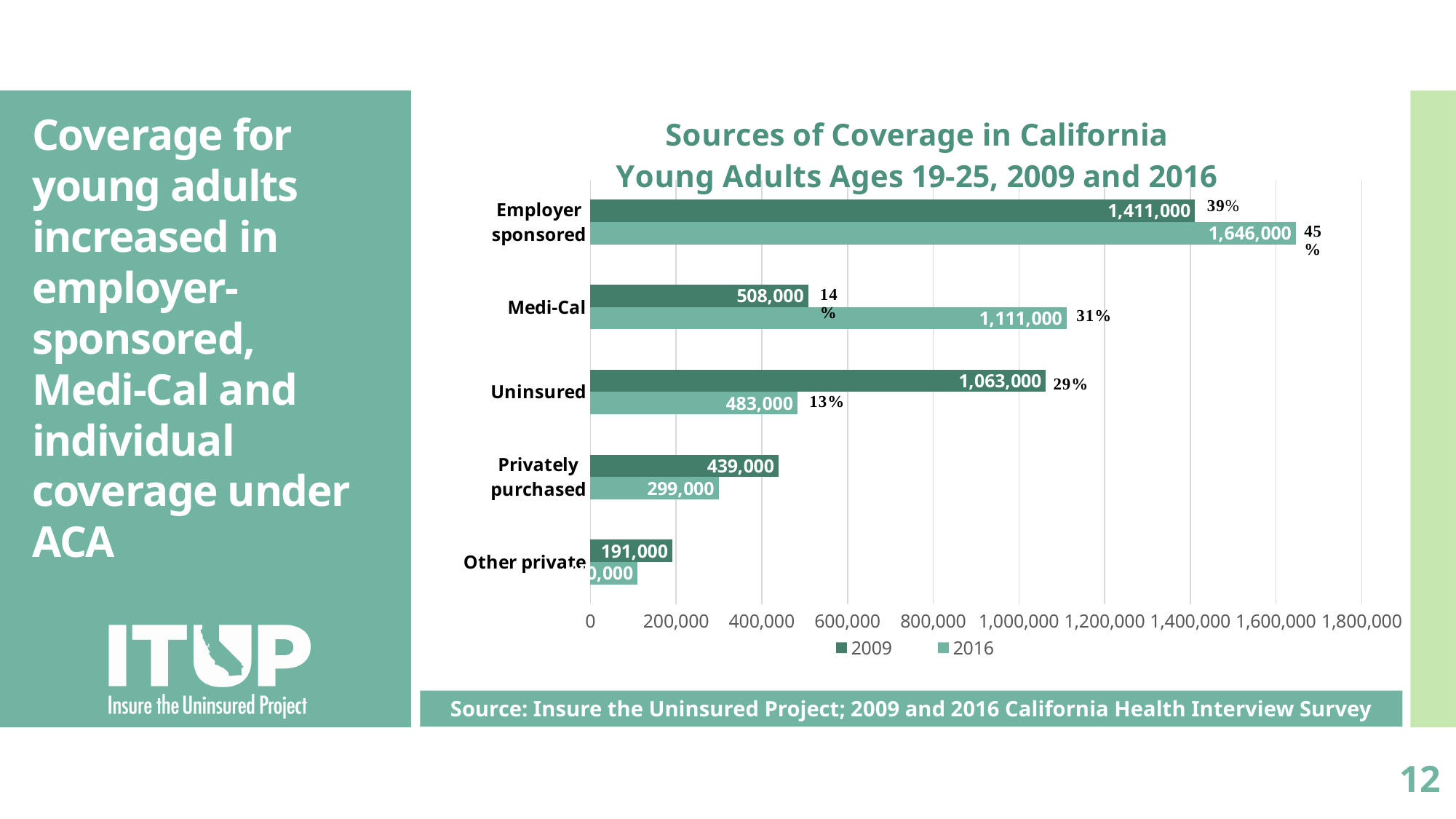
How many series does the legend list? 2 What percentage label is shown next to the 2016 Medi-Cal bar? 31% What is the 2009 value for Privately purchased coverage? 439,000 Which category has the highest 2016 value? Employer sponsored What is the 2016 value for Uninsured? 483,000 What is the 2016 value for Employer sponsored coverage? 1,646,000 Which category has the lowest 2009 value? Other private What type of chart is shown on the slide? Bar chart What is the difference between the 2016 and 2009 values for Medi-Cal? 603,000 What is the 2009 value for Medi-Cal? 508,000 How many coverage categories are shown on the chart? 5 Which is larger for Uninsured: the 2009 value or the 2016 value? 2009